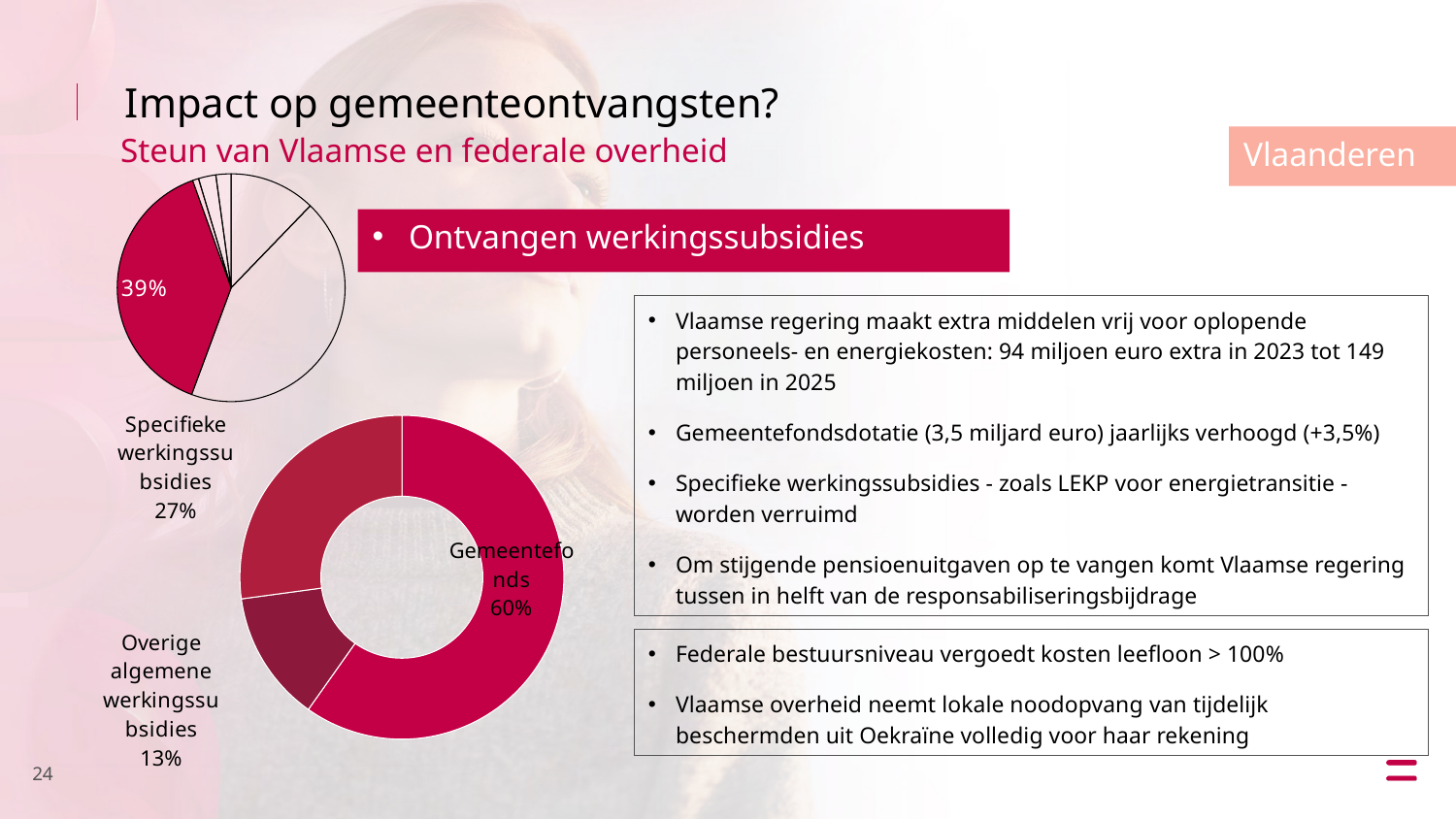
What kind of chart is the lower chart on the left of the slide? Doughnut chart In the doughnut chart, which category has the largest share? Gemeentefonds In the doughnut chart, what share is shown for Specifieke werkingssubsidies? 27% How many categories are shown in the doughnut chart? 3 In the pie chart in the top-left corner, what percentage is printed on the labelled slice? 39% In the doughnut chart, what is the difference in percentage points between Specifieke werkingssubsidies and Overige algemene werkingssubsidies? 14 percentage points What kind of chart is the chart in the top-left corner of the slide? Pie chart In the doughnut chart, how many percentage points larger is Gemeentefonds than Specifieke werkingssubsidies? 33 percentage points In the doughnut chart, what share is shown for Gemeentefonds? 60% In the doughnut chart, which is larger: Specifieke werkingssubsidies or Overige algemene werkingssubsidies? Specifieke werkingssubsidies In the doughnut chart, what share is shown for Overige algemene werkingssubsidies? 13% In the doughnut chart, which category has the smallest share? Overige algemene werkingssubsidies